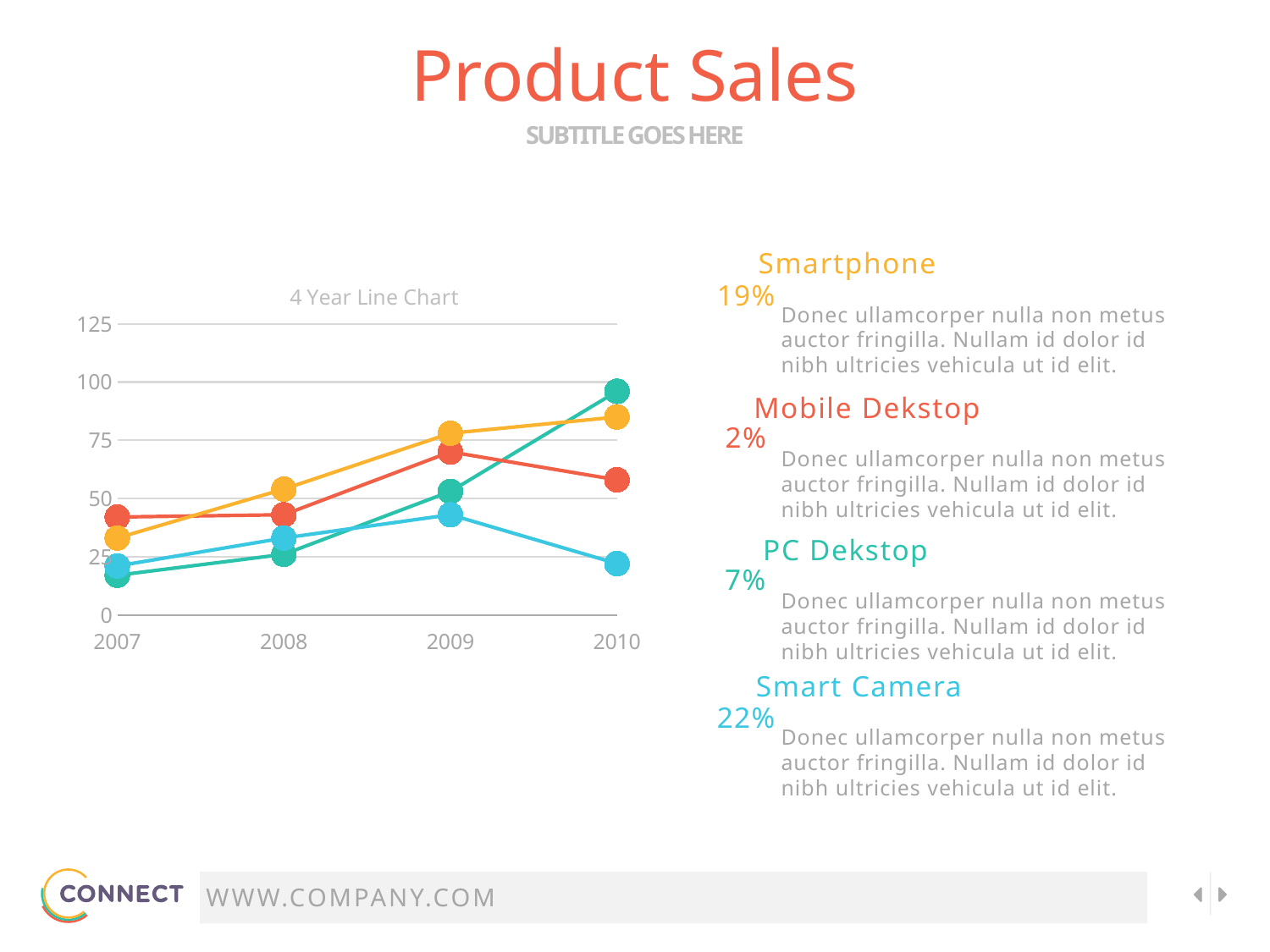
Is the value of the yellow line in 2009 greater or less than 50? greater What kind of chart is shown on the slide? line chart Which line has the lowest value in 2010? the blue line Which line has the highest value in 2010? the green line Is the value of the green line in 2007 greater or less than 25? less How many lines are plotted in the chart? 4 What is the title of the chart? 4 Year Line Chart Is the value of the blue line in 2010 greater or less than 50? less Does the yellow line rise or fall from 2007 to 2010? rise How many years are shown on the x axis of the chart? 4 In 2008, which is larger: the yellow line or the red line? the yellow line